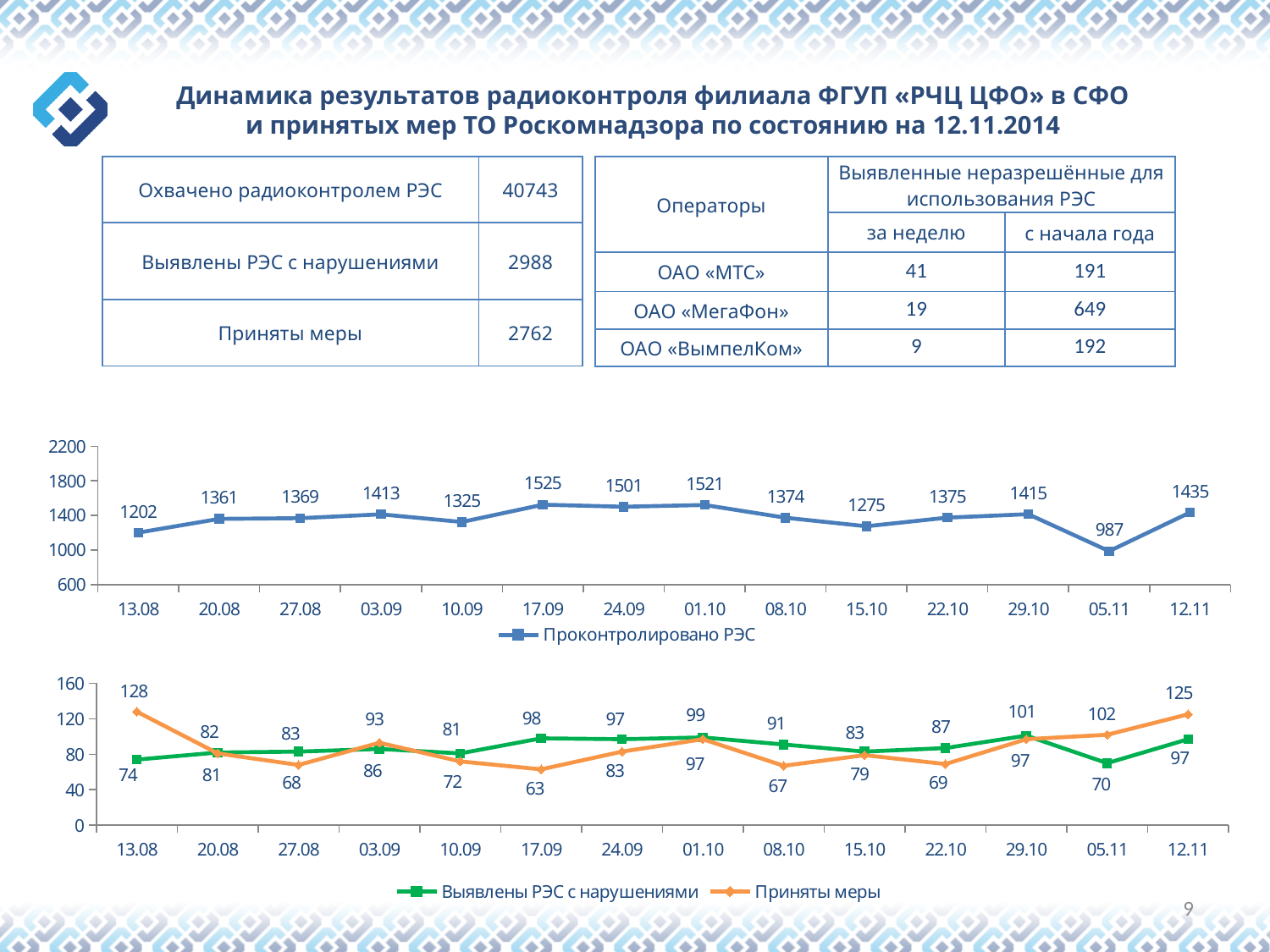
In the bottom chart, what is the value of Выявлены РЭС с нарушениями for 17.09? 98 In the top chart (Проконтролировано РЭС), which date has the highest value? 17.09 In the top chart (Проконтролировано РЭС), what is the difference between the values for 12.11 and 05.11? 448 In the top chart (Проконтролировано РЭС), what is the value for 05.11? 987 In the top chart (Проконтролировано РЭС), what is the value for 13.08? 1202 What type of chart is the top chart on the slide? Line chart In the bottom chart, which is larger for 03.09: Выявлены РЭС с нарушениями or Приняты меры? Приняты меры In the top chart (Проконтролировано РЭС), how many dates are plotted on the x axis? 14 In the bottom chart, what is the value of Приняты меры for 13.08? 128 In the top chart (Проконтролировано РЭС), which date has the lowest value? 05.11 In the bottom chart, which date has the lowest value for Приняты меры? 17.09 How many series does the legend of the bottom chart list? 2